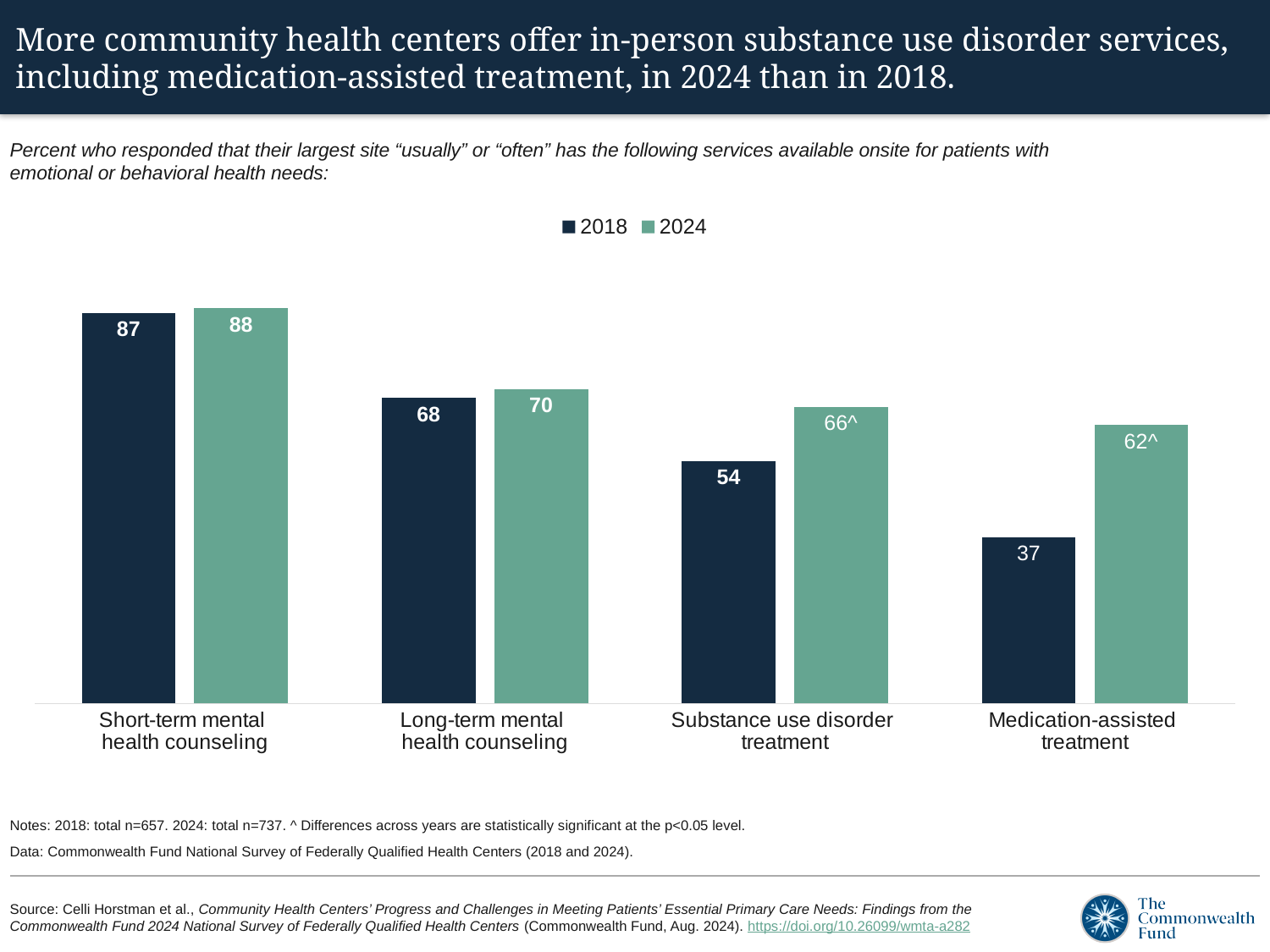
Which category has the highest 2024 value? Short-term mental health counseling What is the 2018 value for Short-term mental health counseling? 87 Is the 2018 value for Substance use disorder treatment larger or smaller than the 2018 value for Long-term mental health counseling? smaller What is the difference between the 2024 and 2018 values for Substance use disorder treatment? 12 How many series does the legend list? 2 What is the 2024 value for Medication-assisted treatment? 62 What is the difference between the 2024 and 2018 values for Medication-assisted treatment? 25 Which category has the lowest 2018 value? Medication-assisted treatment What is the 2018 value for Substance use disorder treatment? 54 What kind of chart is shown on the slide? bar chart What is the 2024 value for Long-term mental health counseling? 70 How many categories are shown on the x axis? 4